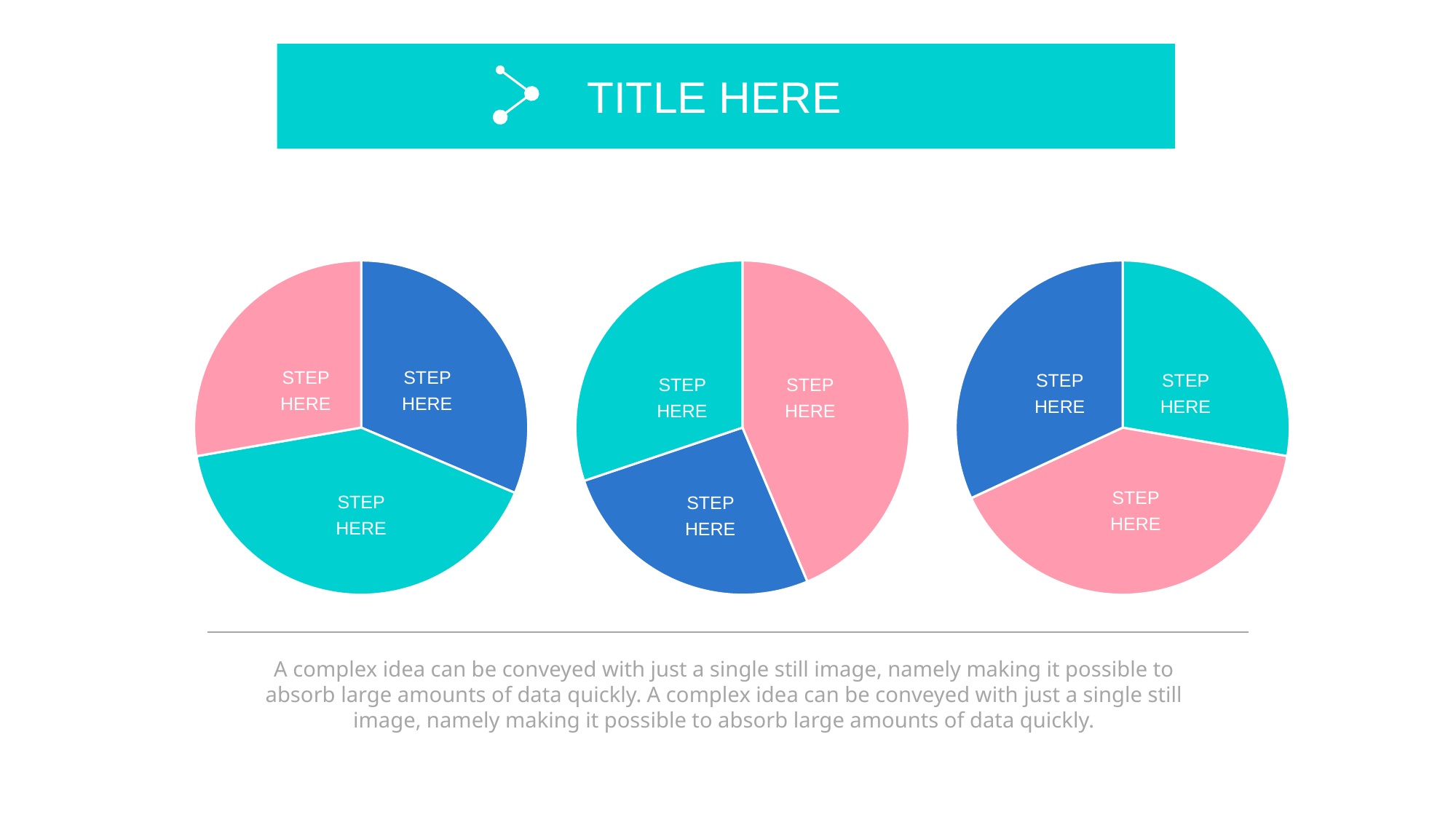
What is the title shown in the banner above the charts? TITLE HERE What kind of chart is the left chart on the slide? Pie chart How many pie charts are shown on the slide? 3 How many slices does the right pie chart have? 3 How many slices does the middle pie chart have? 3 In the middle pie chart, is the pink slice larger or smaller than the blue slice? Larger In the right pie chart, which colour slice is the largest? Pink What label appears on every slice of the three pie charts? STEP HERE In the middle pie chart, which colour slice is the largest? Pink In the left pie chart, which colour slice is the largest? Teal